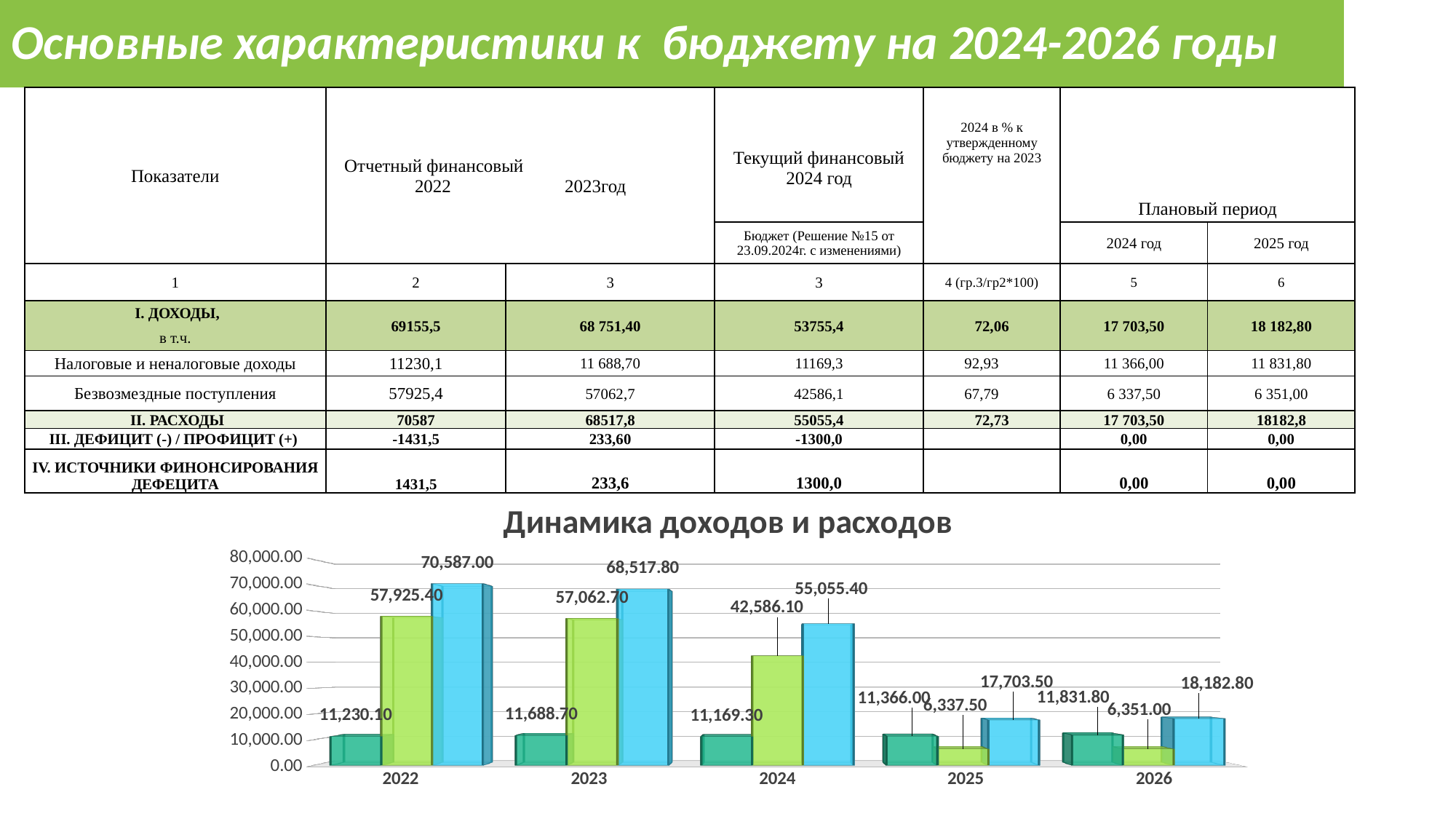
Which is larger in 2025: the dark teal bar or the light green bar? the dark teal bar What is the value of the dark teal bar for 2026 in the chart? 11,831.80 What kind of chart is shown under the table? bar chart Is the value of the blue bar for 2024 greater or less than 50,000.00? greater What is the title of the chart on the slide? Динамика доходов и расходов Do the values of the blue bars rise or fall from 2022 to 2025? fall In which year is the light green bar the lowest? 2025 In which year does the blue bar reach its highest value? 2022 What is the value of the light green bar for 2024 in the chart? 42,586.10 What is the value of the blue bar for 2022 in the chart? 70,587.00 What is the difference between the blue bar and the light green bar for 2023? 11,455.10 How many year categories are shown on the x axis of the chart? 5